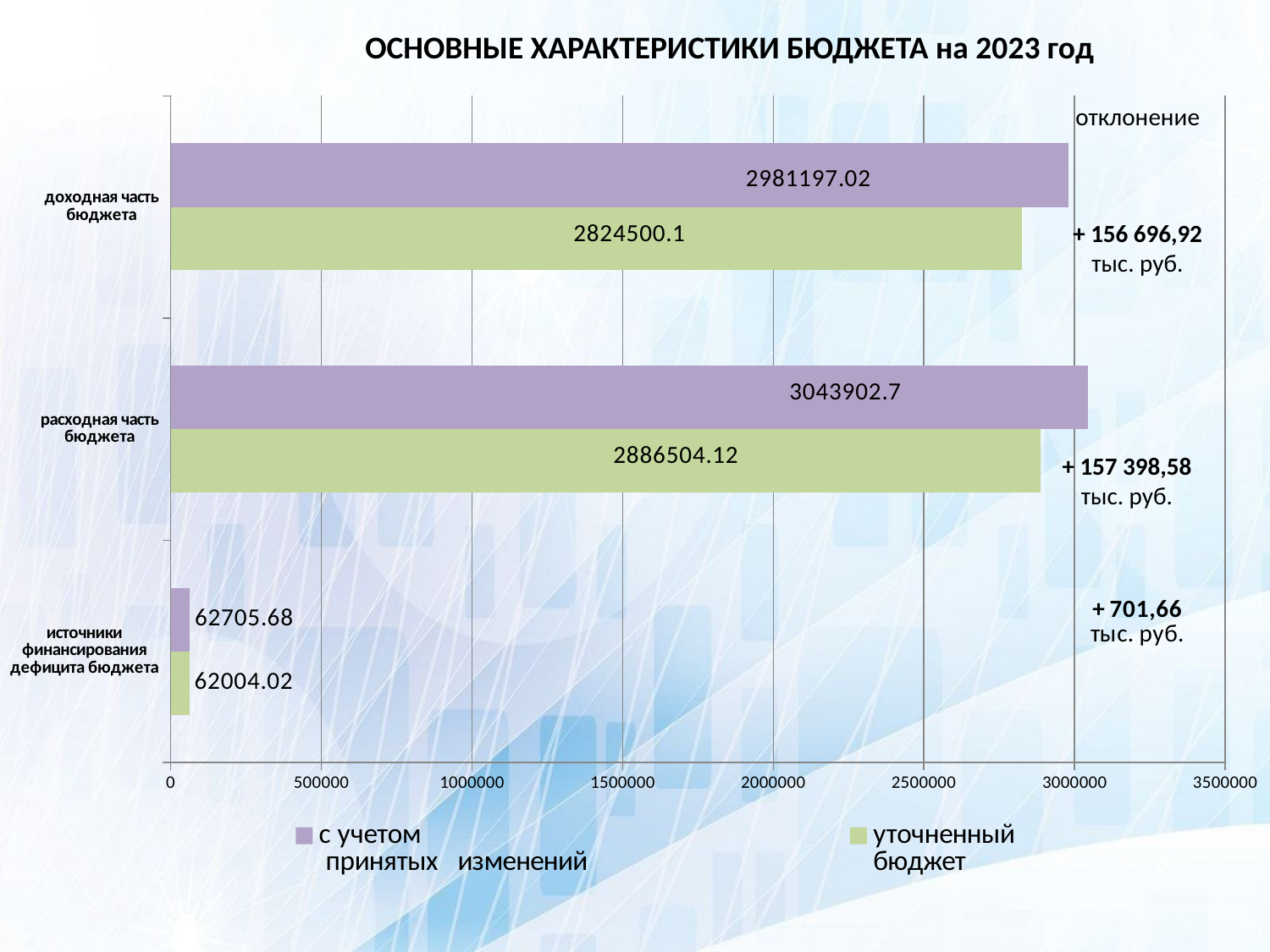
Which category has the lowest value in the series «уточненный бюджет»? источники финансирования дефицита бюджета How many series does the legend list? 2 What is the value for «расходная часть бюджета» in the series «уточненный бюджет»? 2886504.12 What is the value for «доходная часть бюджета» in the series «уточненный бюджет»? 2824500.1 What is the difference between the two series for «расходная часть бюджета»? 157398.58 Which category has the highest value in the series «с учетом принятых изменений»? расходная часть бюджета Is the value for «расходная часть бюджета» in the series «с учетом принятых изменений» greater or less than 3000000? greater How many categories are shown on the chart? 3 What kind of chart is shown on the slide? bar chart Which is larger for «источники финансирования дефицита бюджета»: «с учетом принятых изменений» or «уточненный бюджет»? с учетом принятых изменений What is the value for «доходная часть бюджета» in the series «с учетом принятых изменений»? 2981197.02 What is the value for «источники финансирования дефицита бюджета» in the series «с учетом принятых изменений»? 62705.68